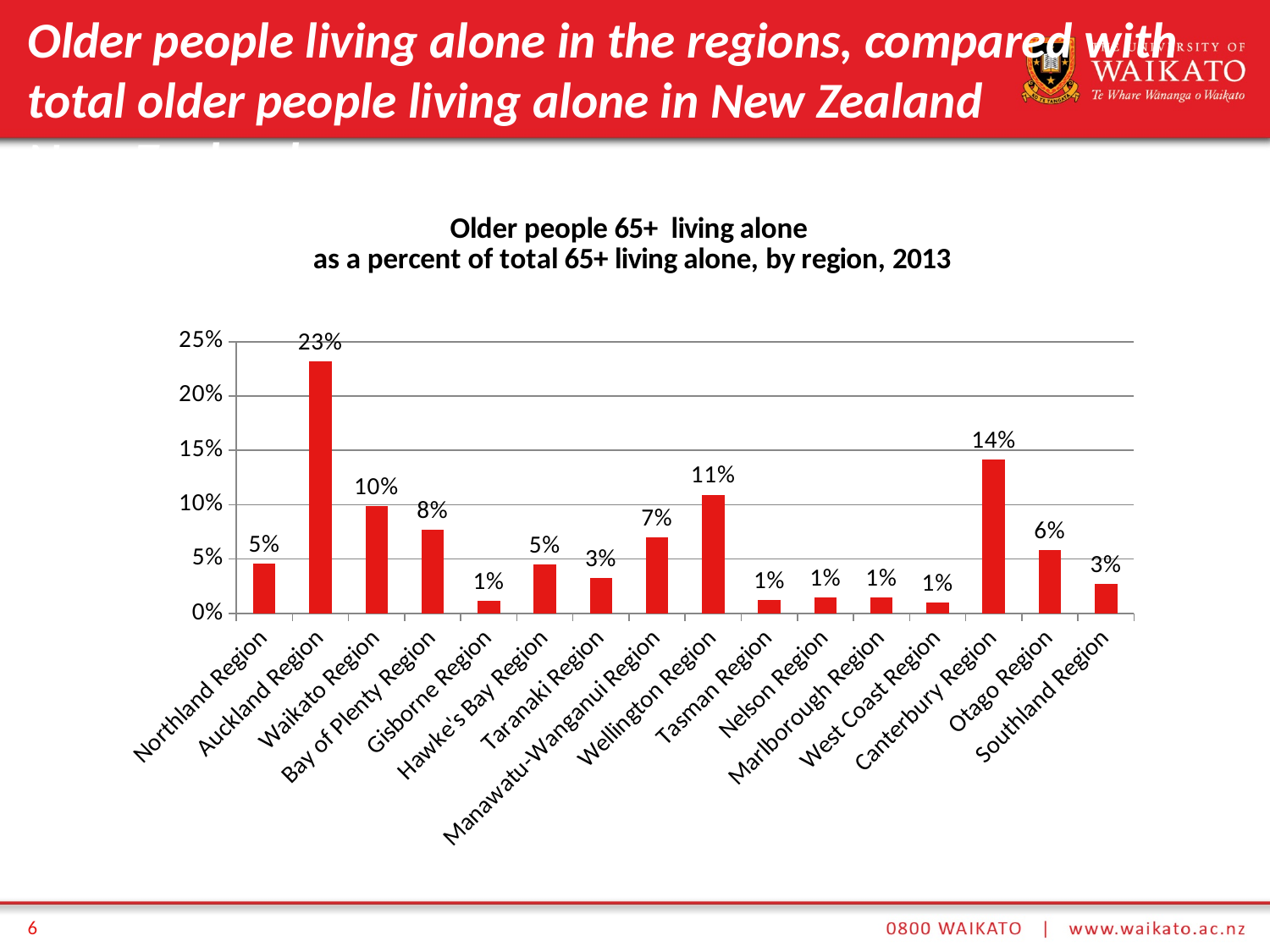
What is the value for Otago Region? 6% What kind of chart is shown on the slide? bar chart How many regions are shown on the x axis? 16 What is the value for Wellington Region? 11% What is the difference between the values for Wellington Region and Manawatu-Wanganui Region? 4% What is the value for Canterbury Region? 14% Is the value for Auckland Region greater or less than 20%? greater Which is larger, the value for Waikato Region or the value for Bay of Plenty Region? Waikato Region What year does the chart title say the data is for? 2013 Which region has the highest value? Auckland Region What is the difference between the values for Auckland Region and Canterbury Region? 9% What is the value for Auckland Region? 23%